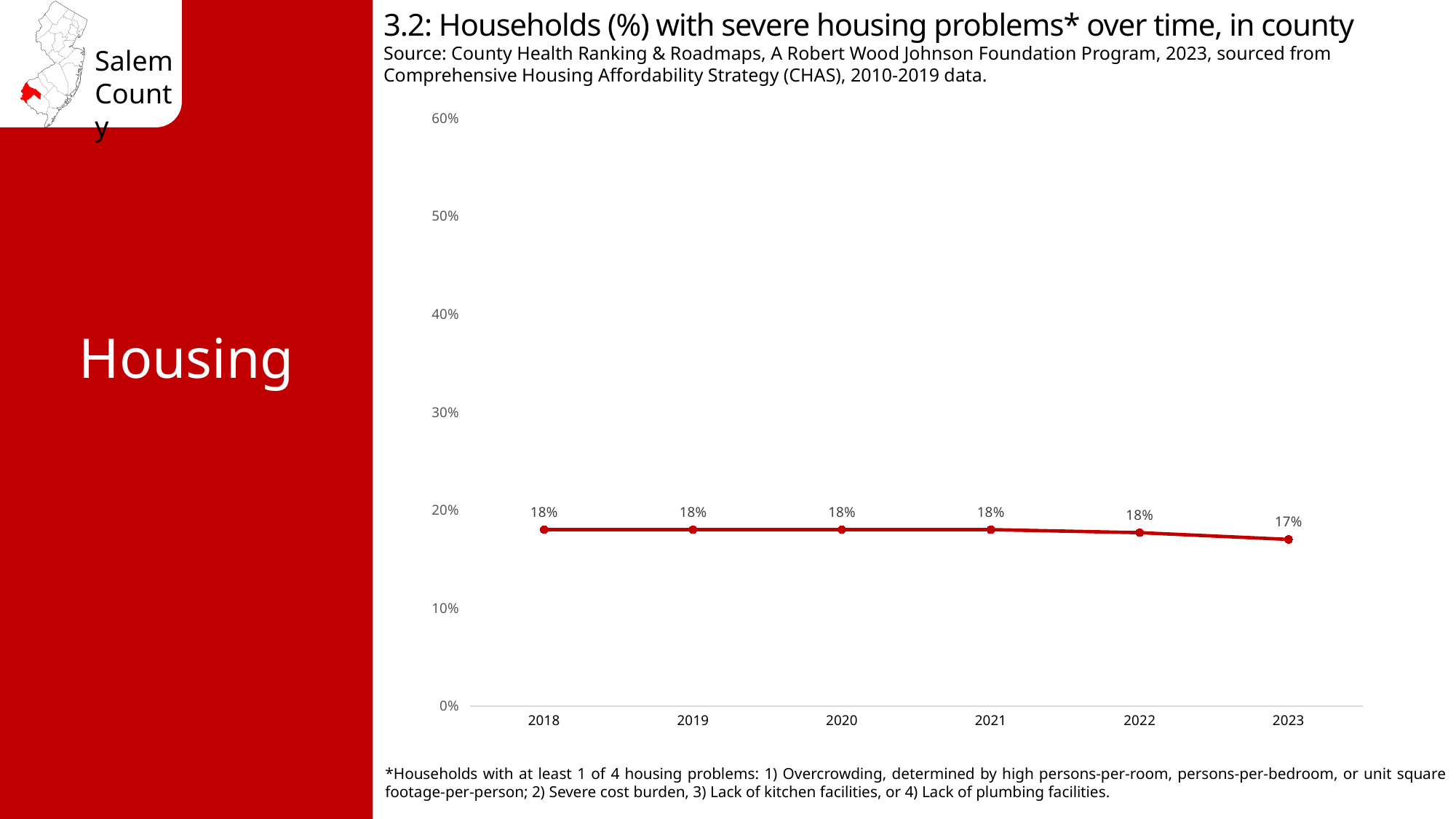
What is the difference between the values for 2018 and 2023? 1% What kind of chart is shown on the slide? line chart How many years are plotted on the chart? 6 What is the value for 2021? 18% Is the value for 2022 greater or less than 20%? less Do the values rise, fall, or stay roughly flat from 2018 to 2023? roughly flat, with a slight fall at the end What is the highest value shown on the y axis? 60% Which year has the lowest value? 2023 What is the value for 2023? 17% What is the value for 2018? 18% What is the title of the chart? 3.2: Households (%) with severe housing problems* over time, in county Which is larger, the value for 2020 or the value for 2023? 2020